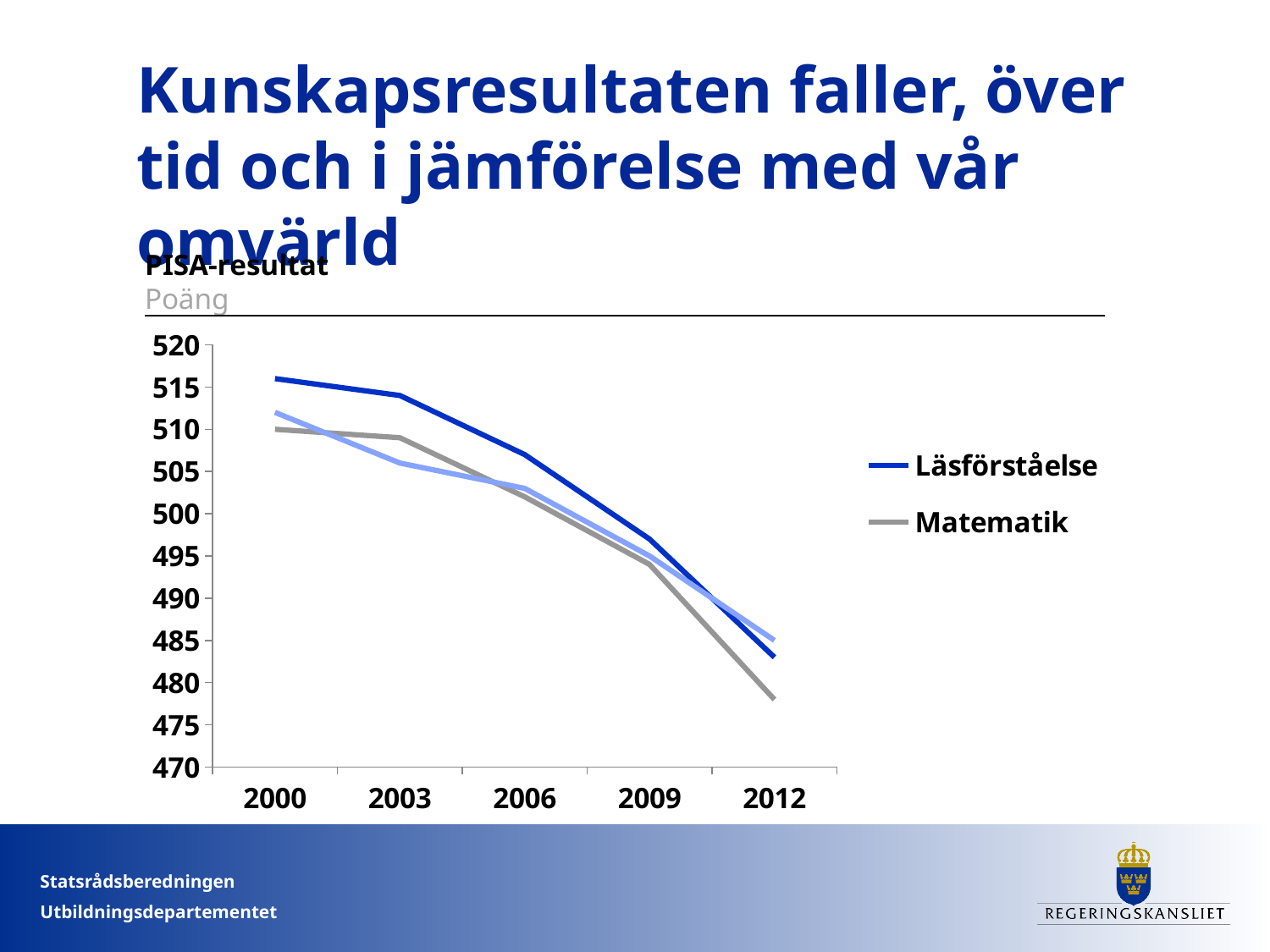
In 2000, which is higher: Läsförståelse or Matematik? Läsförståelse What is the title of the chart? PISA-resultat Is the Läsförståelse value for 2012 greater or less than 490? less Is the Läsförståelse value for 2006 greater or less than 500? greater How many series does the chart's legend list? 2 In which year is the Läsförståelse value highest? 2000 How many years are plotted along the x axis of the chart? 5 In which year is the Matematik value lowest? 2012 Do the Läsförståelse values rise or fall from 2000 to 2012? Fall Is the Matematik value for 2009 greater or less than 500? less Do the Matematik values rise or fall from 2000 to 2012? Fall What kind of chart is shown on the slide? Line chart